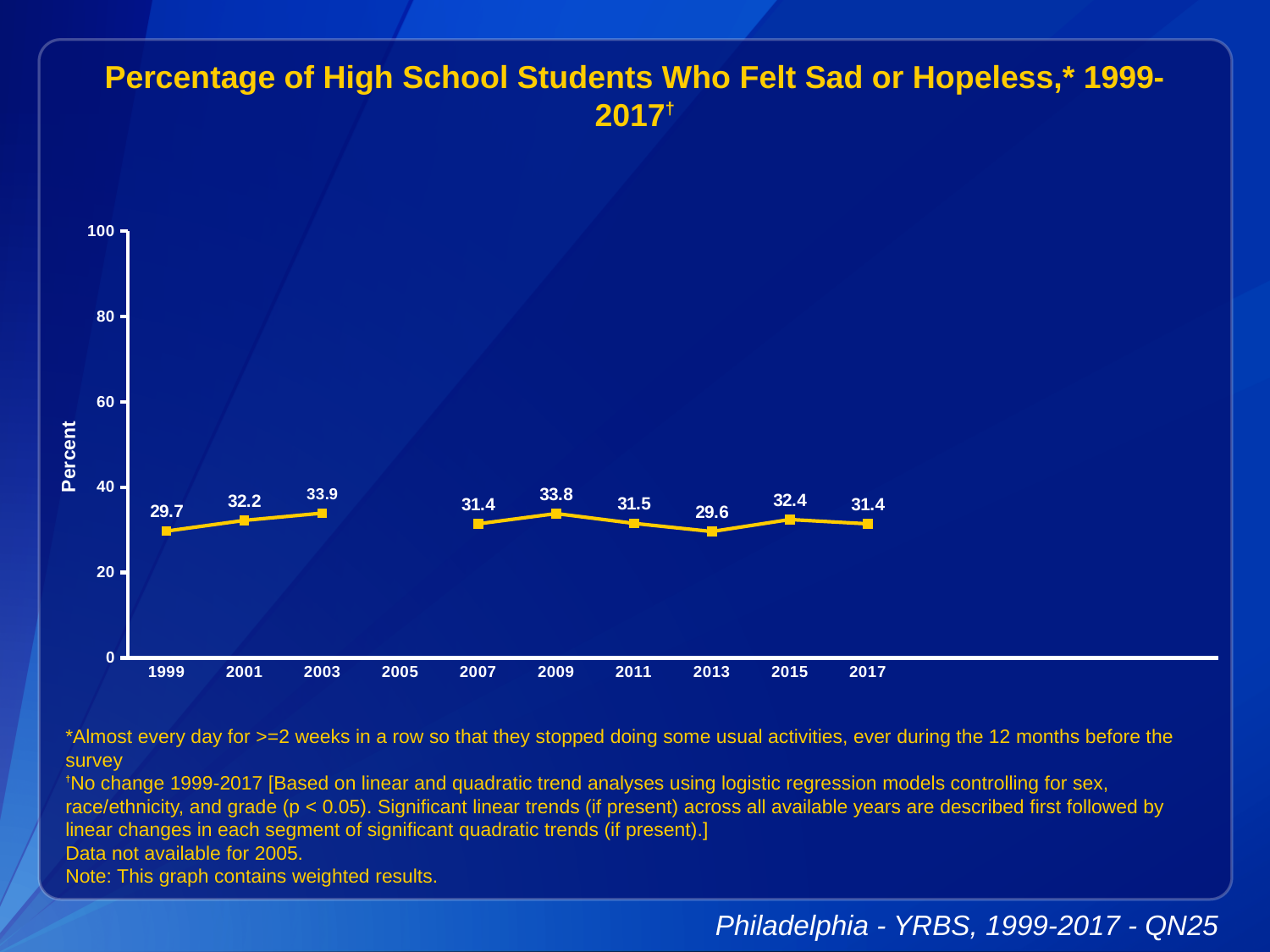
What is the difference between the values for 2015 and 2013? 2.8 What kind of chart is shown on the slide? line chart What is the value plotted for 2017? 31.4 What is the value plotted for 2009? 33.8 Which year has the highest percentage of students who felt sad or hopeless? 2003 What is the difference between the values for 2003 and 1999? 4.2 How many years have data points plotted on the chart? 9 What is the label on the y axis of the chart? Percent Which year has the lowest percentage of students who felt sad or hopeless? 2013 Is the value for 2007 greater or less than 40? less Which year has a larger value, 2001 or 2009? 2009 What percentage of high school students felt sad or hopeless in 1999? 29.7